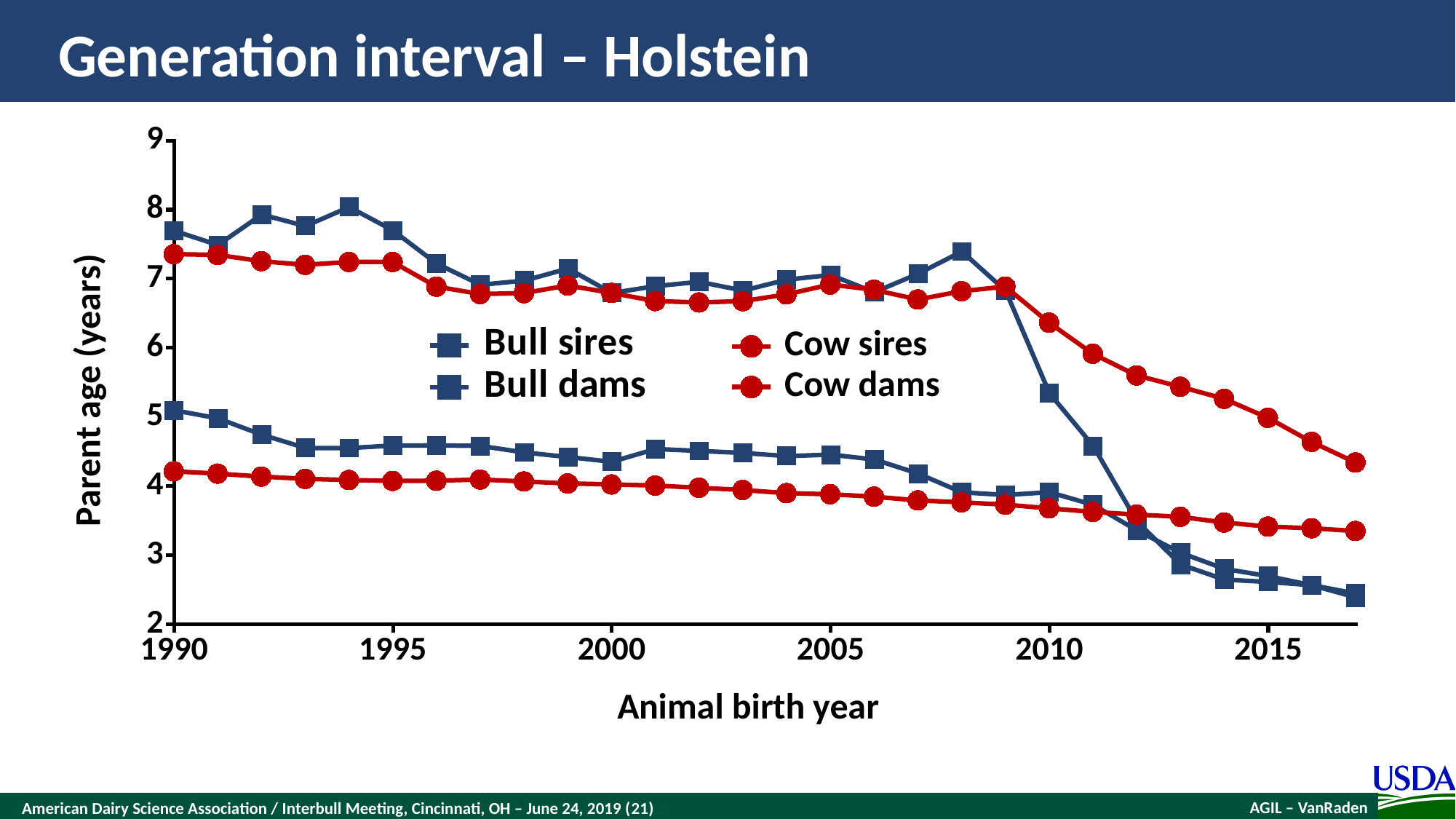
In 2015, which is larger: the value for Cow sires or the value for Bull sires? Cow sires Do the values for Bull sires rise or fall from 2009 to 2017? Fall Which series has the lowest value in 1990? Cow dams Is the value for Cow sires in 2010 greater or less than 6? greater Is the value for Bull sires in 2008 greater or less than 7? greater What is the title of the chart? Generation interval – Holstein How many series does the legend list? 4 What is the label of the y axis? Parent age (years) In 2017, which is larger: the value for Cow dams or the value for Bull dams? Cow dams What kind of chart is shown on the slide? Line chart Is the value for Cow sires in 2017 greater or less than 4? greater